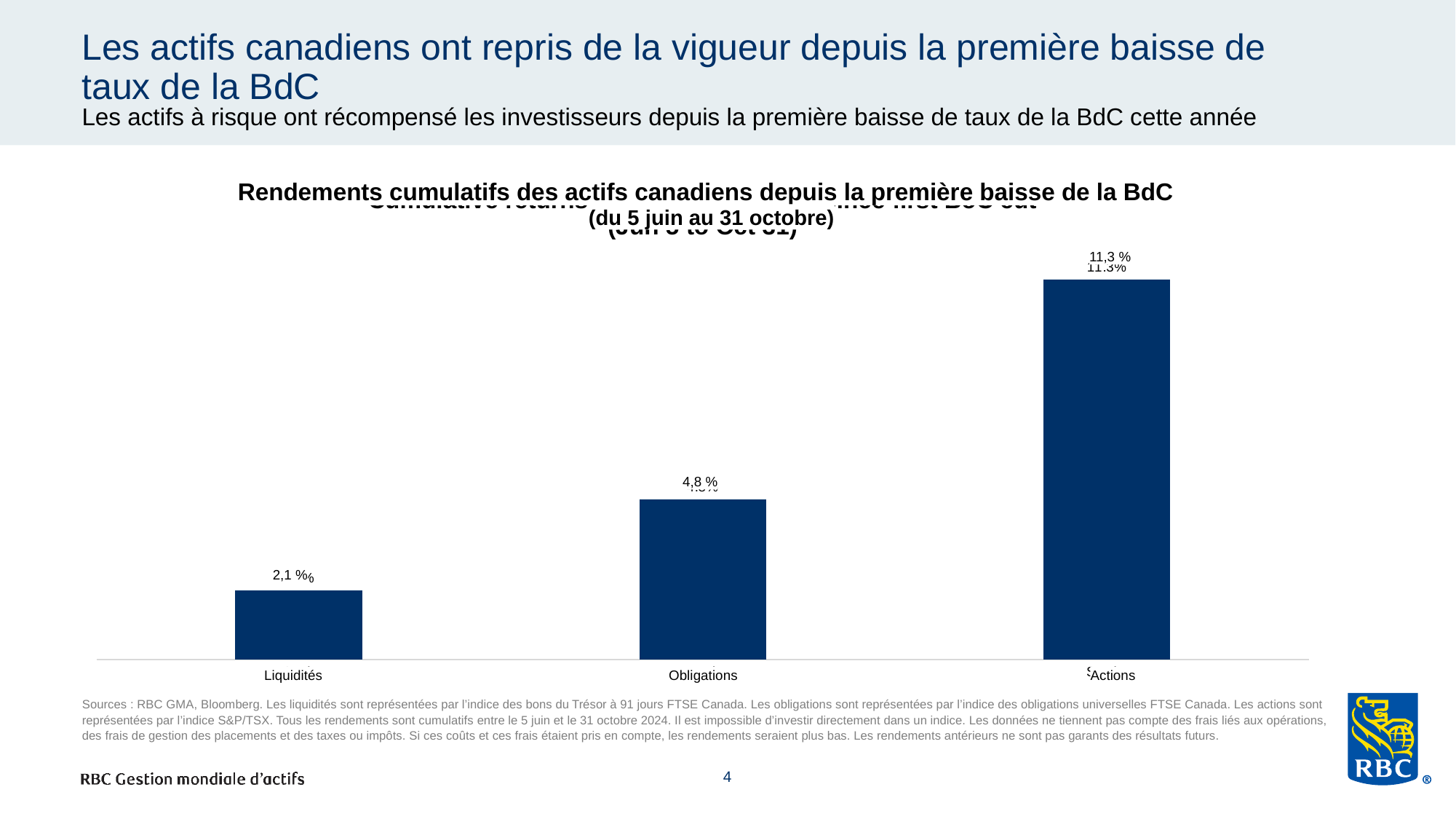
Which has a larger cumulative return, Obligations or Liquidités? Obligations What kind of chart is shown on the slide? Bar chart Which category has the lowest cumulative return? Liquidités How many categories are shown in the chart? 3 What is the difference between the returns for Obligations and Liquidités? 2,7 % Do the values rise or fall from left to right across the categories? Rise What is the difference between the returns for Actions and Obligations? 6,5 % What is the cumulative return shown for Obligations? 4,8 % What is the difference between the returns for Actions and Liquidités? 9,2 % What is the cumulative return shown for Liquidités? 2,1 % Which category has the highest cumulative return? Actions What is the cumulative return shown for Actions? 11,3 %